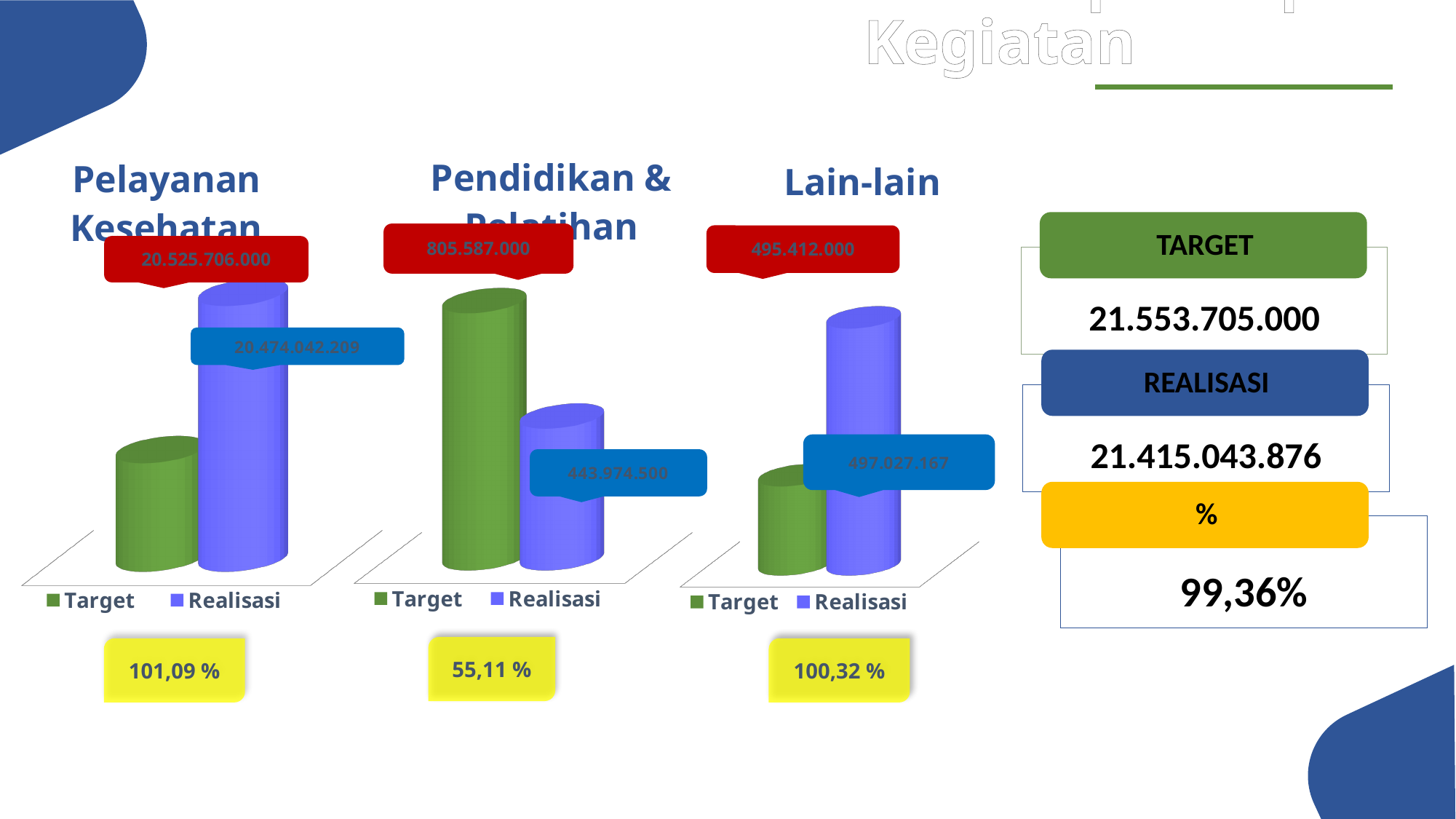
What kind of chart is the Lain-lain chart? Bar chart In the Pendidikan & Pelatihan chart, what is the Target value? 805.587.000 In the Pelayanan Kesehatan chart, what is the Target value? 20.525.706.000 In the Lain-lain chart, what is the Realisasi value? 497.027.167 How many series does the legend of the Pelayanan Kesehatan chart list? 2 In the Pendidikan & Pelatihan chart, what is the Realisasi value? 443.974.500 In the Lain-lain chart, which is larger, Target or Realisasi? Realisasi In the Pendidikan & Pelatihan chart, which is larger, Target or Realisasi? Target In the Lain-lain chart, what is the difference between Realisasi and Target? 1.615.167 In the Pendidikan & Pelatihan chart, what is the difference between Target and Realisasi? 361.612.500 In the Pelayanan Kesehatan chart, what is the Realisasi value? 20.474.042.209 In the Lain-lain chart, what is the Target value? 495.412.000